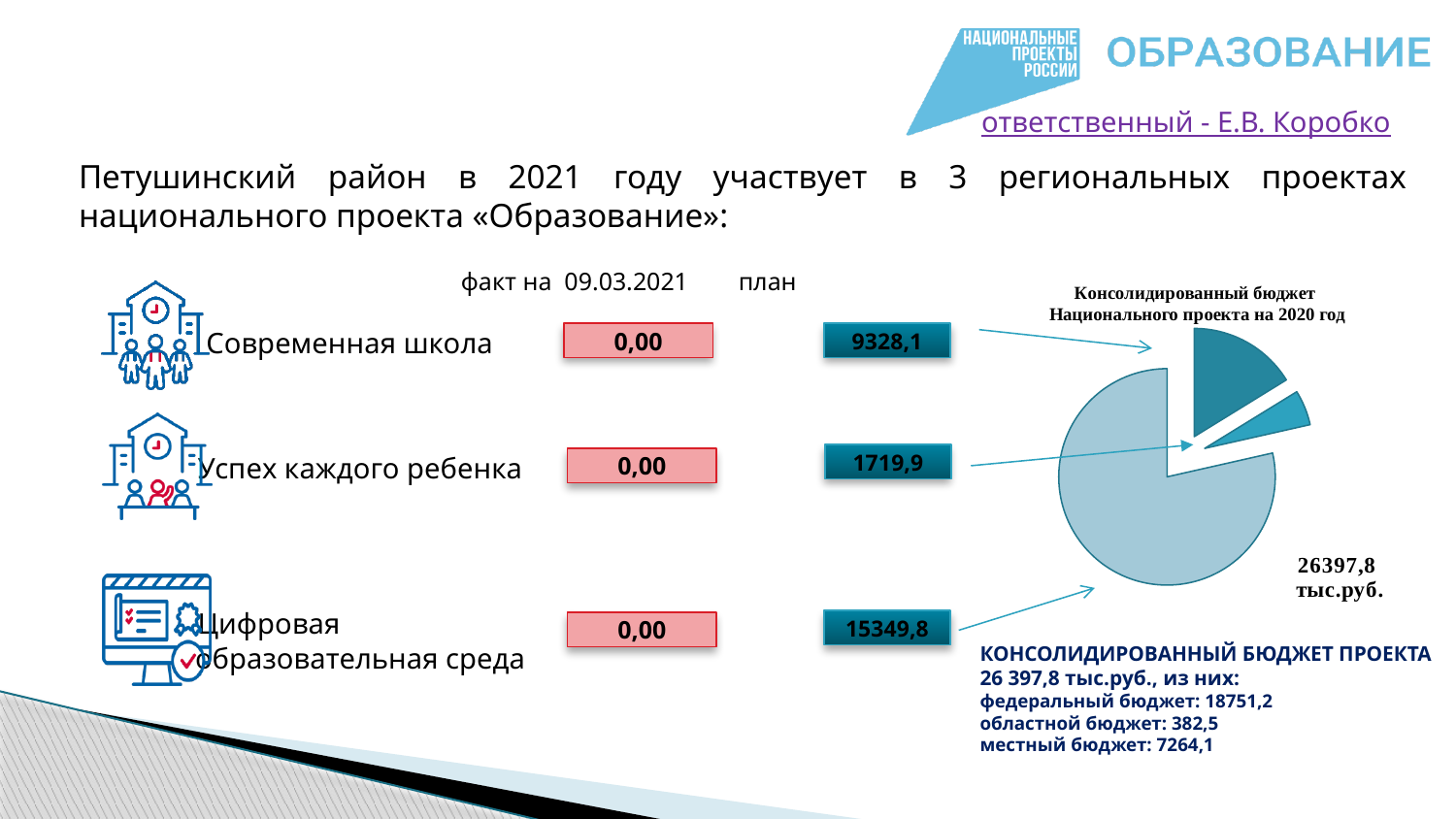
How many slices does the pie chart have? 3 What plan value is linked by an arrow to the dark teal slice of the pie chart? 9328,1 What is the title of the pie chart? Консолидированный бюджет Национального проекта на 2020 год Which project does the largest slice of the pie chart correspond to, according to the arrows? Цифровая образовательная среда Does the pie chart have a legend? No What plan value is linked by an arrow to the smallest slice of the pie chart? 1719,9 Which slice is larger in the pie chart: the one for Современная школа or the one for Успех каждого ребенка? Современная школа What kind of chart is shown on the right side of the slide? pie chart What total value is printed next to the pie chart? 26397,8 тыс.руб. What is the difference between the plan values linked to the largest and smallest slices of the pie chart? 13629,9 What plan value is linked by an arrow to the largest slice of the pie chart? 15349,8 Which project does the smallest slice of the pie chart correspond to, according to the arrows? Успех каждого ребенка